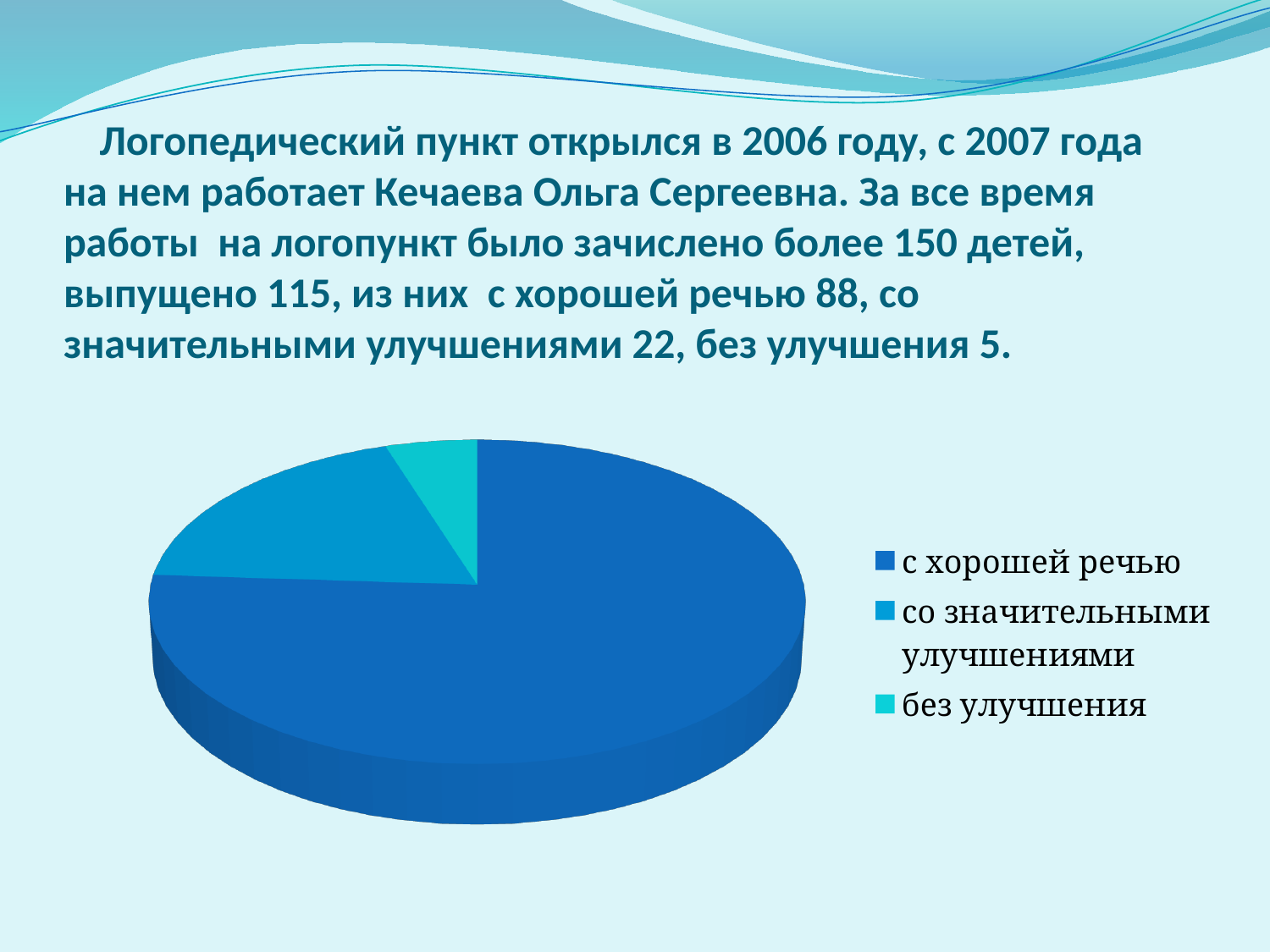
Which category has the smallest slice of the pie chart? без улучшения Does the slice for "с хорошей речью" take up more or less than half of the pie? more How many slices does the pie chart have? 3 Which slice is larger: "со значительными улучшениями" or "без улучшения"? со значительными улучшениями What kind of chart is shown on the slide? pie chart How many entries does the legend of the pie chart list? 3 Which category has the largest slice of the pie chart? с хорошей речью Which legend entry is listed first in the pie chart's legend? с хорошей речью Which legend entry is shown in the lightest (turquoise) colour? без улучшения Which slice is larger: "с хорошей речью" or "со значительными улучшениями"? с хорошей речью